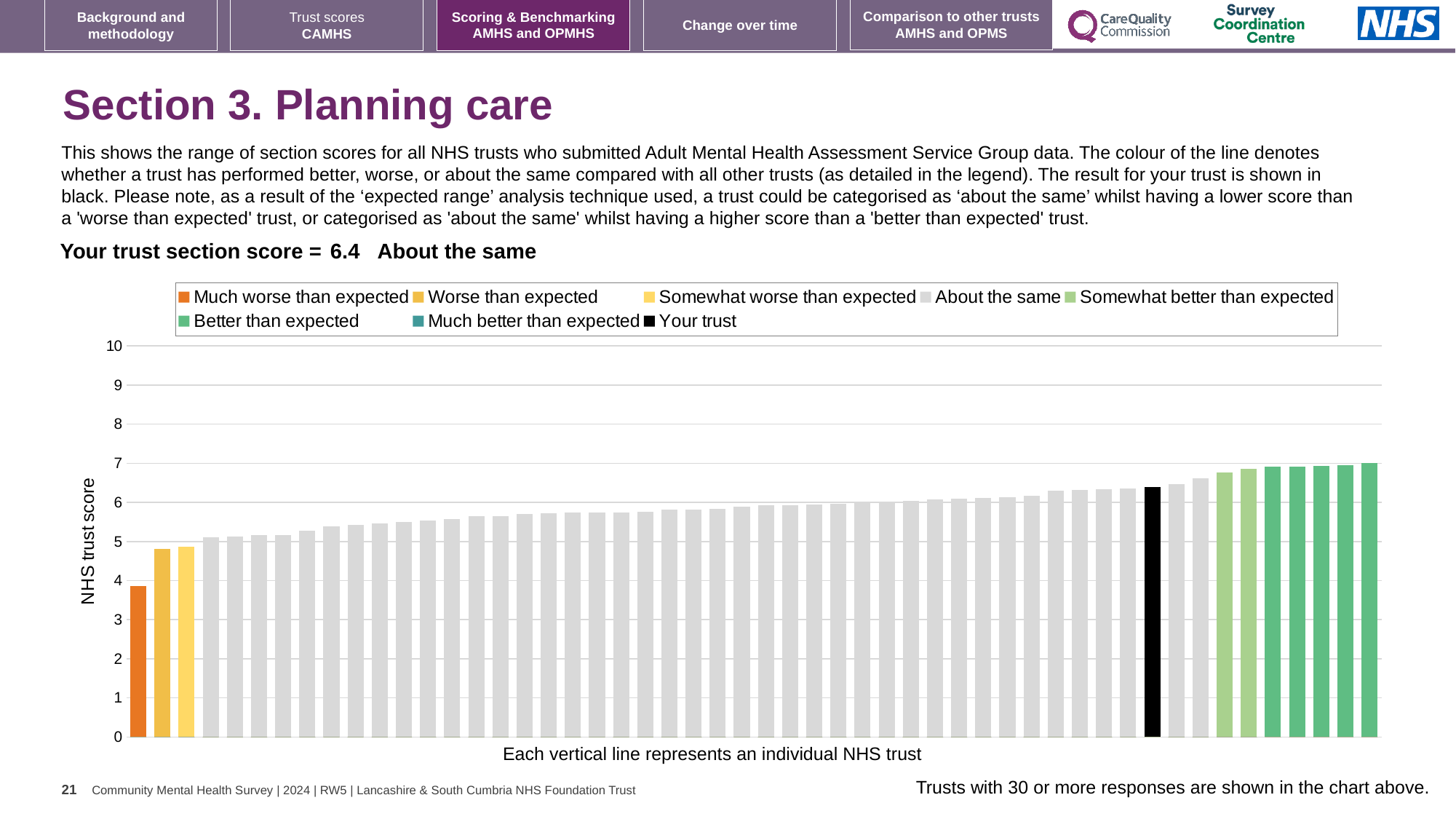
Which legend category do the tallest bars belong to? Better than expected What is the section score for your trust shown on the slide? 6.4 Is the value for the tallest bar greater or less than 8? less Which legend category does the lowest bar belong to? Much worse than expected Which is larger: the value for your trust (black bar) or the value for the orange bar? your trust (black bar) What colour is used for the bar representing your trust? black Do the bar values rise or fall from left to right along the x axis? rise Is the value for the lowest bar (Much worse than expected) greater or less than 5? less What is the label on the vertical axis of the chart? NHS trust score How many entries does the chart legend list? 8 Is the value for your trust (the black bar) greater or less than 6? greater What kind of chart is shown on the slide? bar chart